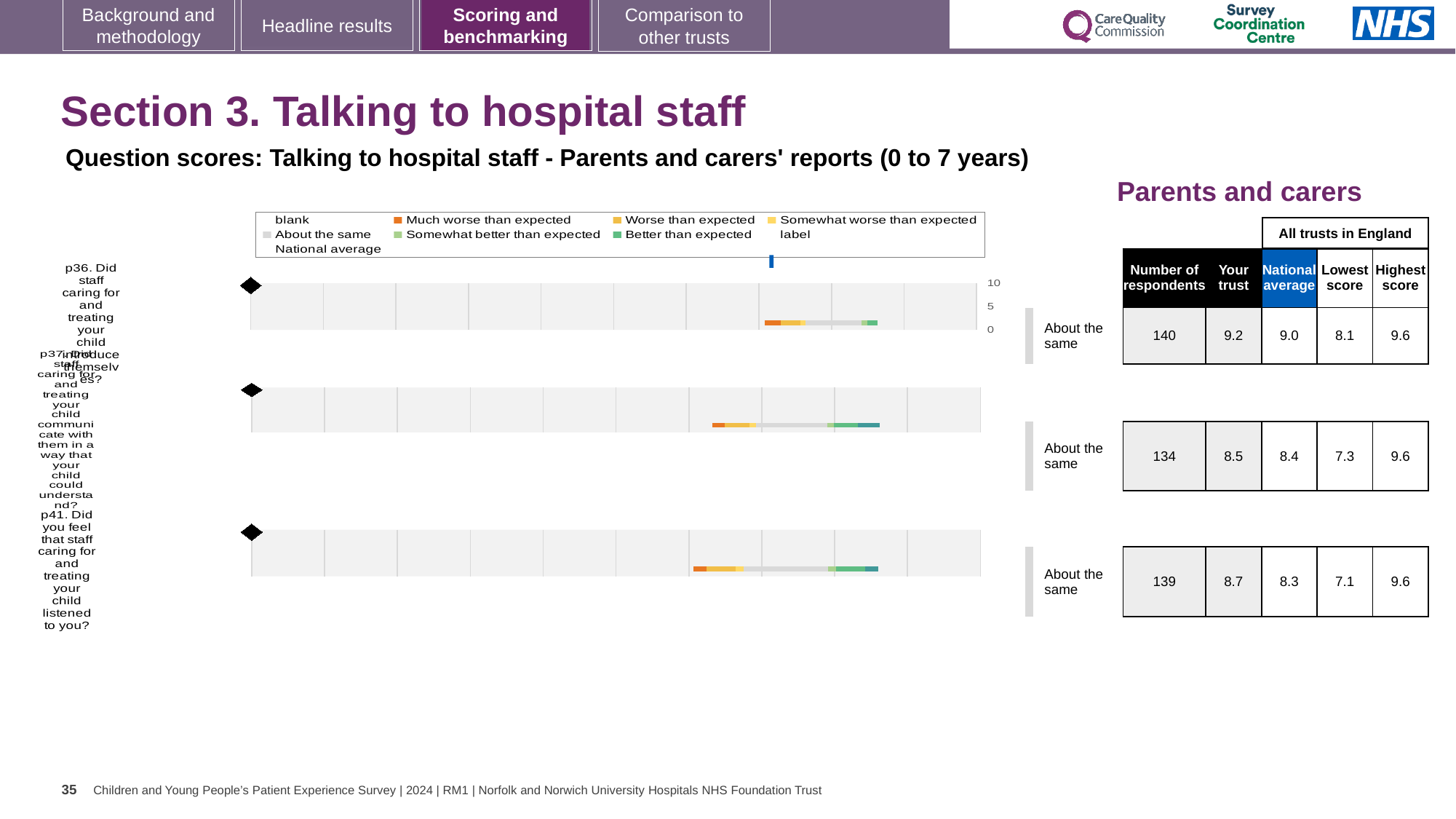
What is the 'Your trust' score for question p37? 8.5 What is the top value shown on the vertical axis of the charts? 10 What is the highest score across all trusts in England for question p37? 9.6 Which question has the lowest 'Lowest score' across all trusts in England? p41 (7.1) What benchmark label is shown next to the chart for question p36? About the same What is the national average score for question p41? 8.3 Which question has the highest 'Your trust' score? p36 (9.2) For question p36, what is the difference between the 'Your trust' score and the national average? 0.2 For question p36, how many respondents are shown in the table? 140 For question p41, which is larger: the 'Your trust' score or the national average? Your trust (8.7) What kind of chart is used to show the question scores on this slide? Bar chart How many survey questions (p36, p37, p41) are charted on this slide? 3